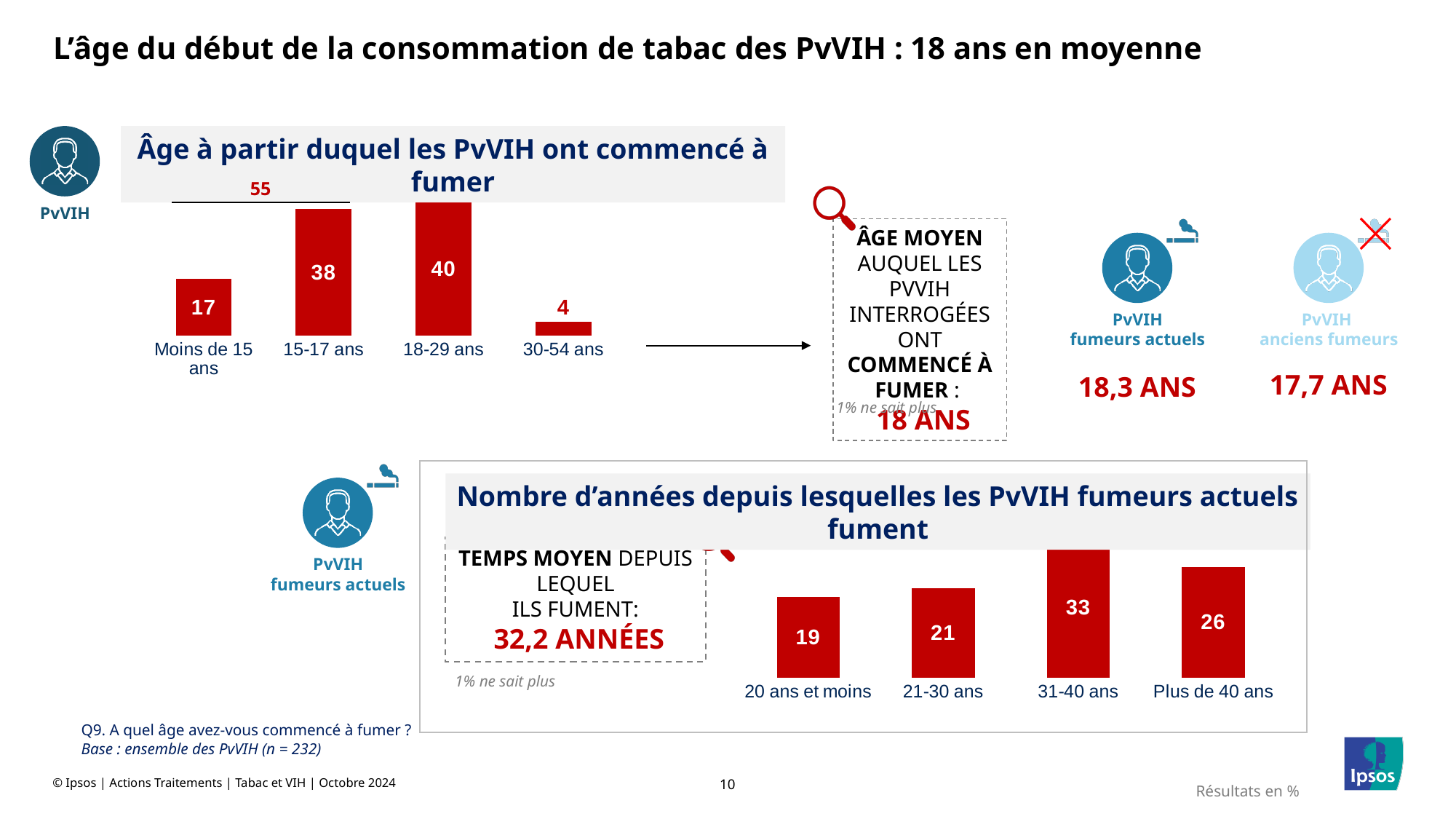
In the chart 'Âge à partir duquel les PvVIH ont commencé à fumer', which category has the highest value? 18-29 ans In the chart 'Âge à partir duquel les PvVIH ont commencé à fumer', what is the value for '15-17 ans'? 38 In the chart 'Nombre d'années depuis lesquelles les PvVIH fumeurs actuels fument', what is the value for 'Plus de 40 ans'? 26 In the chart 'Âge à partir duquel les PvVIH ont commencé à fumer', which category has the lowest value? 30-54 ans In the chart 'Âge à partir duquel les PvVIH ont commencé à fumer', what is the value for '30-54 ans'? 4 In the chart 'Nombre d'années depuis lesquelles les PvVIH fumeurs actuels fument', which is larger: '21-30 ans' or 'Plus de 40 ans'? Plus de 40 ans What type of chart is 'Nombre d'années depuis lesquelles les PvVIH fumeurs actuels fument'? Bar chart In the chart 'Âge à partir duquel les PvVIH ont commencé à fumer', how many categories are shown? 4 In the chart 'Nombre d'années depuis lesquelles les PvVIH fumeurs actuels fument', which category has the lowest value? 20 ans et moins In the chart 'Nombre d'années depuis lesquelles les PvVIH fumeurs actuels fument', what is the value for '31-40 ans'? 33 In the chart 'Âge à partir duquel les PvVIH ont commencé à fumer', what is the difference between the values for '18-29 ans' and 'Moins de 15 ans'? 23 In the chart 'Âge à partir duquel les PvVIH ont commencé à fumer', what combined value is shown by the bracket above 'Moins de 15 ans' and '15-17 ans'? 55